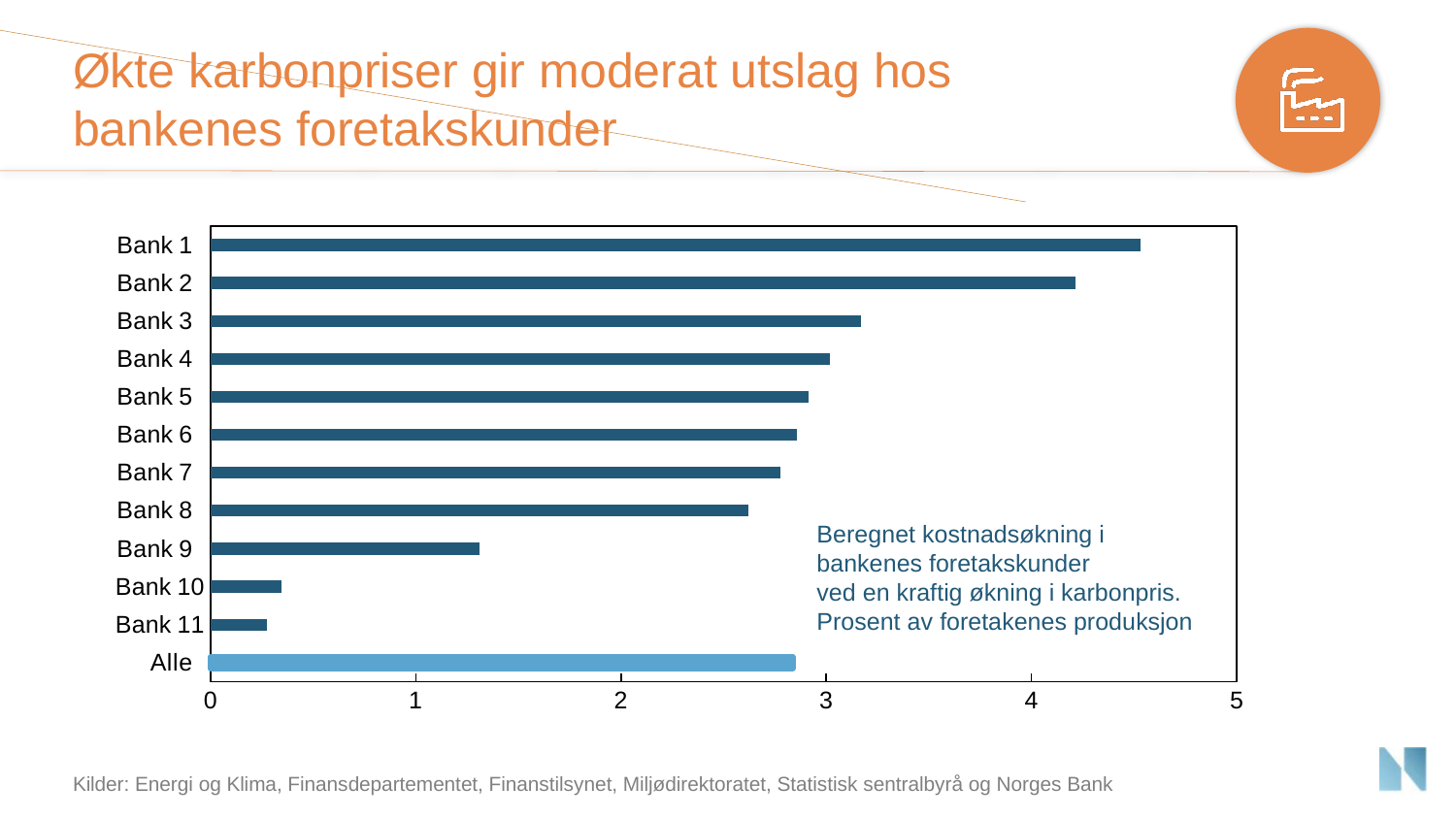
Is the value for Bank 8 greater or less than 3? less What kind of chart is shown on the slide? bar chart Is the value for Bank 1 greater or less than 4? greater Is the value for Bank 3 greater or less than 3? greater Do the bank values rise or fall going from Bank 1 down to Bank 11? fall Which is larger, the value for Bank 2 or the value for Bank 3? Bank 2 Which category is drawn in a lighter blue colour than the others? Alle Which is larger, the value for Bank 9 or the value for Bank 7? Bank 7 How many categories are plotted on the chart? 12 Which category has the highest value? Bank 1